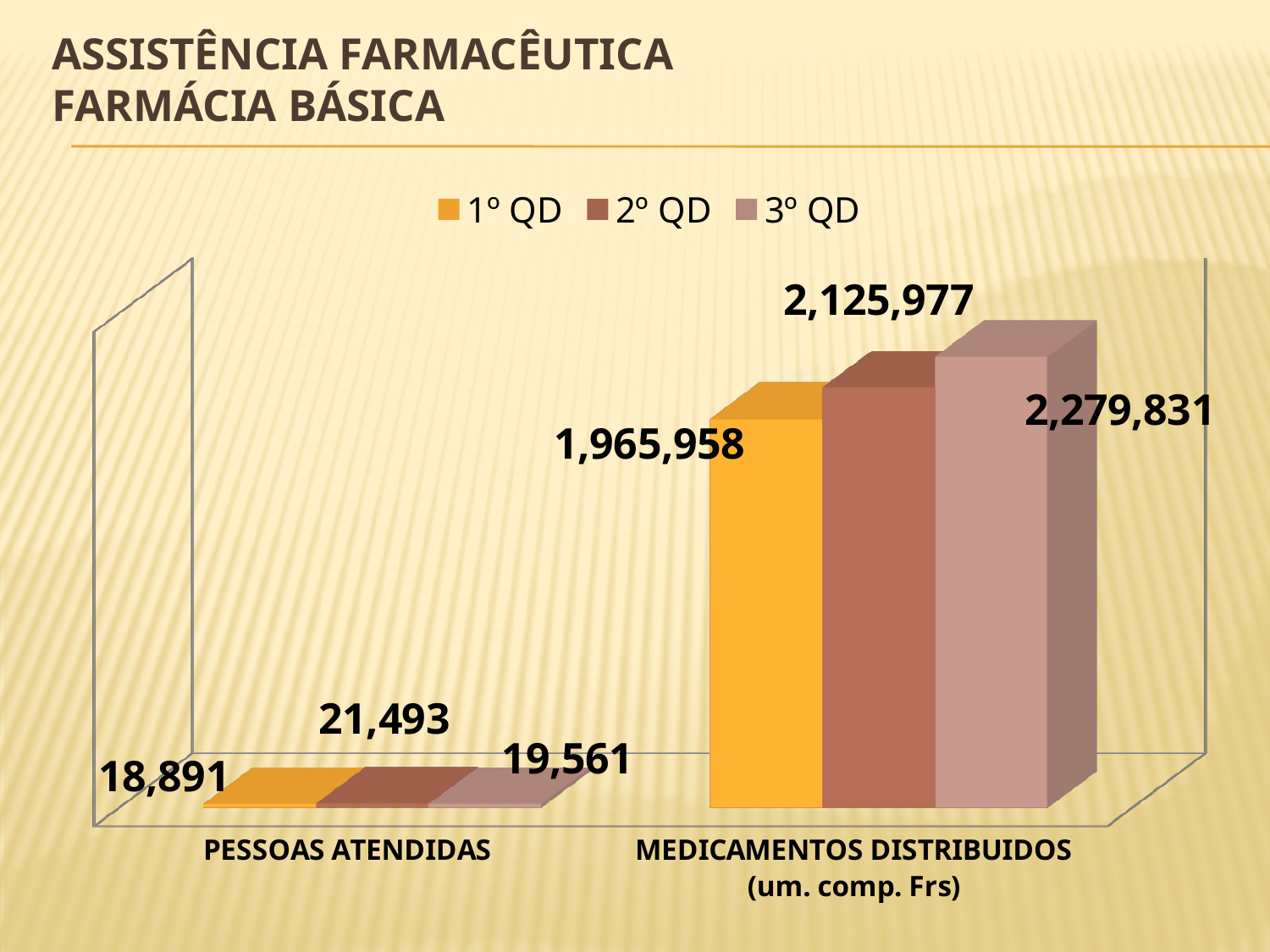
How many series does the legend list? 3 Which is larger for PESSOAS ATENDIDAS: the 2º QD value or the 3º QD value? 2º QD What is the value for 1º QD in the PESSOAS ATENDIDAS category? 18,891 What is the value for 3º QD in the MEDICAMENTOS DISTRIBUIDOS category? 2,279,831 What is the difference between the 2º QD and 1º QD values for PESSOAS ATENDIDAS? 2,602 What is the difference between the 3º QD and 1º QD values for MEDICAMENTOS DISTRIBUIDOS? 313,873 Which series has the lowest value in the PESSOAS ATENDIDAS category? 1º QD What is the value for 1º QD in the MEDICAMENTOS DISTRIBUIDOS category? 1,965,958 What is the value for 2º QD in the PESSOAS ATENDIDAS category? 21,493 Which series has the highest value in the MEDICAMENTOS DISTRIBUIDOS category? 3º QD How many categories are shown on the x axis? 2 What kind of chart is shown on the slide? Bar chart